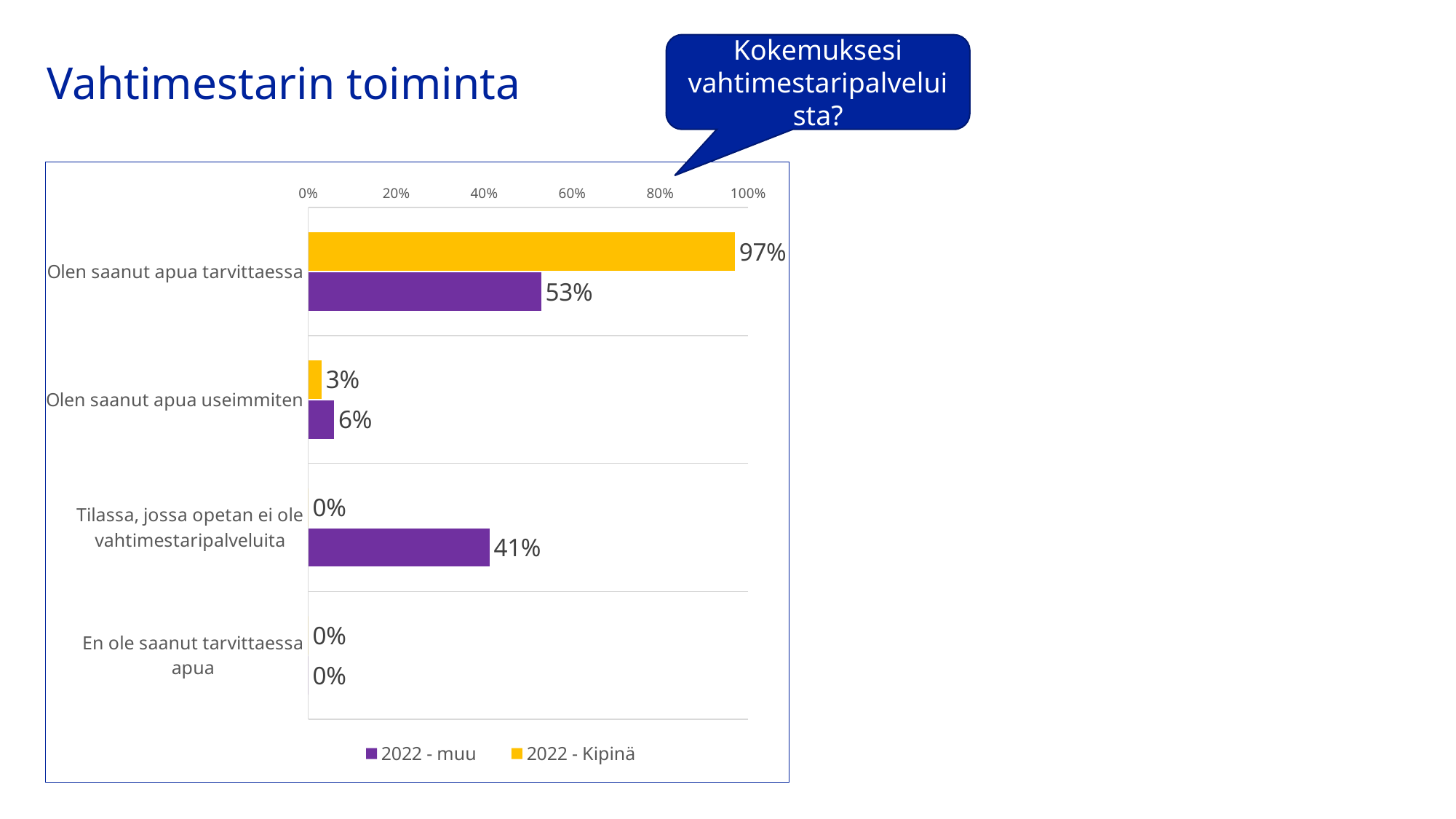
How many series does the legend list? 2 What is the value for "2022 - Kipinä" in the category "Olen saanut apua useimmiten"? 3% Which category has the highest value for the "2022 - muu" series? Olen saanut apua tarvittaessa How many categories are shown on the chart? 4 What kind of chart is shown on the slide? Bar chart What is the value for "2022 - Kipinä" in the category "En ole saanut tarvittaessa apua"? 0% What is the value for "2022 - Kipinä" in the category "Olen saanut apua tarvittaessa"? 97% For "Olen saanut apua useimmiten", which series has the larger value, "2022 - muu" or "2022 - Kipinä"? 2022 - muu What is the value for "2022 - muu" in the category "Olen saanut apua tarvittaessa"? 53% What is the difference between the "2022 - Kipinä" and "2022 - muu" values for "Olen saanut apua tarvittaessa"? 44% Which colour represents the "2022 - Kipinä" series? Yellow What is the value for "2022 - muu" in the category "Tilassa, jossa opetan ei ole vahtimestaripalveluita"? 41%